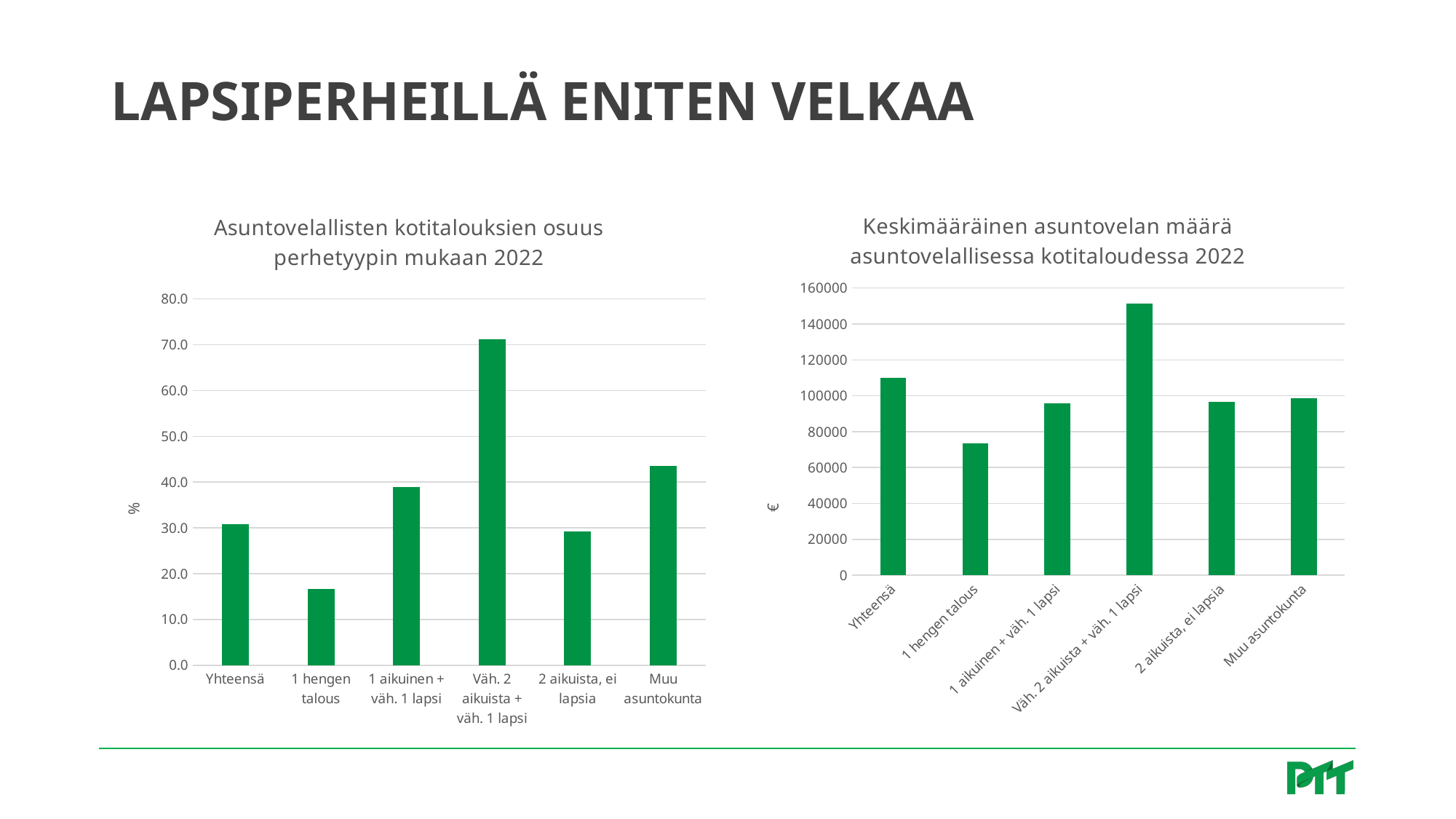
In the right chart (Keskimääräinen asuntovelan määrä asuntovelallisessa kotitaloudessa 2022), is the value for Yhteensä greater or less than 100000? greater In the left chart (Asuntovelallisten kotitalouksien osuus perhetyypin mukaan 2022), is the value for Väh. 2 aikuista + väh. 1 lapsi greater or less than 70.0? greater What type of chart is the right chart (Keskimääräinen asuntovelan määrä asuntovelallisessa kotitaloudessa 2022)? Bar chart In the right chart (Keskimääräinen asuntovelan määrä asuntovelallisessa kotitaloudessa 2022), which family type has the lowest average housing debt? 1 hengen talous In the right chart (Keskimääräinen asuntovelan määrä asuntovelallisessa kotitaloudessa 2022), which is larger: the value for Yhteensä or the value for Muu asuntokunta? Yhteensä In the left chart (Asuntovelallisten kotitalouksien osuus perhetyypin mukaan 2022), which family type has the lowest share? 1 hengen talous In the right chart (Keskimääräinen asuntovelan määrä asuntovelallisessa kotitaloudessa 2022), is the value for 1 hengen talous greater or less than 80000? less In the right chart (Keskimääräinen asuntovelan määrä asuntovelallisessa kotitaloudessa 2022), which family type has the highest average housing debt? Väh. 2 aikuista + väh. 1 lapsi How many categories are shown in the left chart (Asuntovelallisten kotitalouksien osuus perhetyypin mukaan 2022)? 6 In the left chart (Asuntovelallisten kotitalouksien osuus perhetyypin mukaan 2022), which family type has the highest share? Väh. 2 aikuista + väh. 1 lapsi In the left chart (Asuntovelallisten kotitalouksien osuus perhetyypin mukaan 2022), which is larger: the value for Muu asuntokunta or the value for 2 aikuista, ei lapsia? Muu asuntokunta